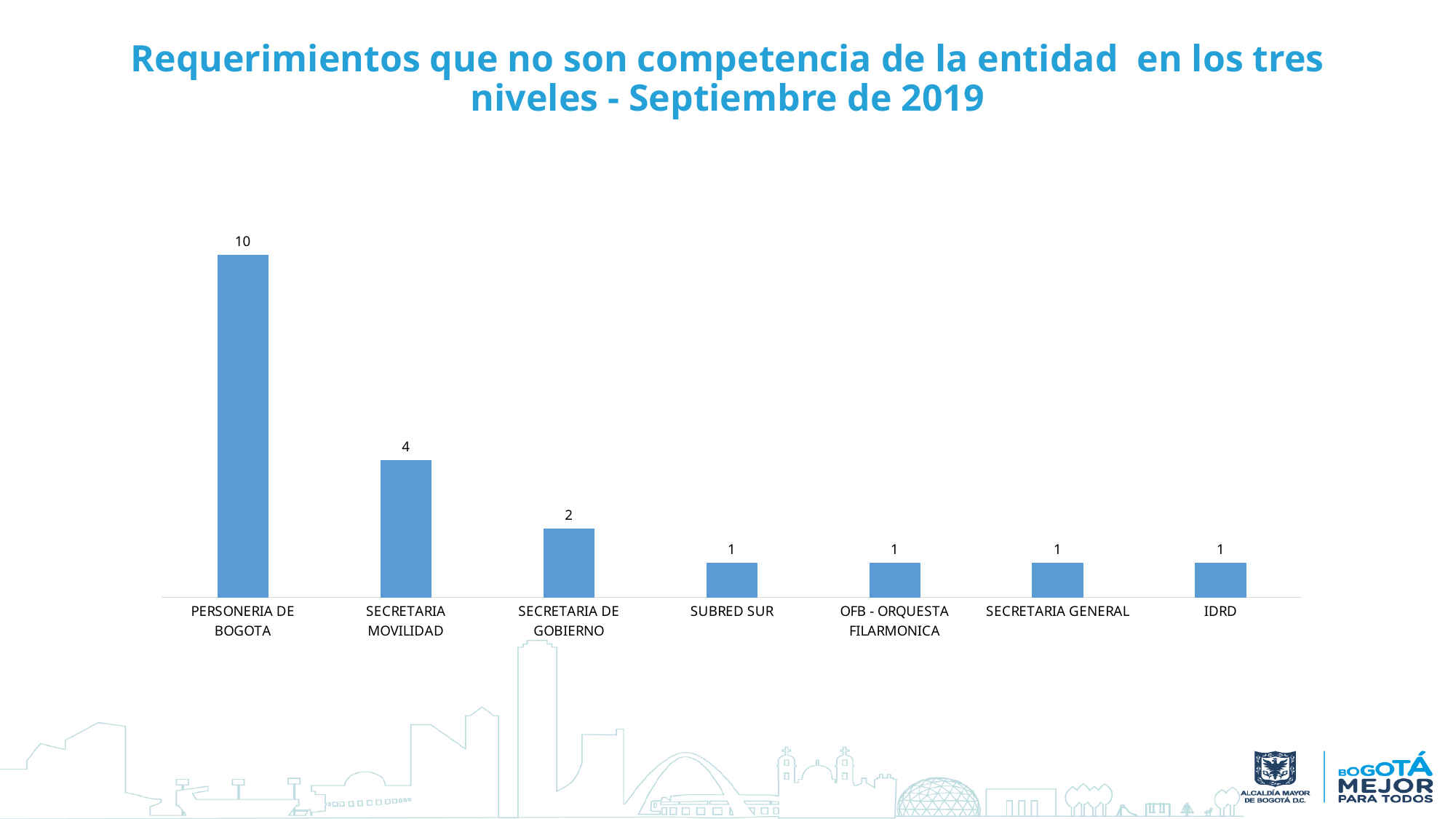
What is the value for SECRETARIA DE GOBIERNO? 2 Do the values rise or fall from left to right along the x axis? Fall What is the value for IDRD? 1 What kind of chart is shown on the slide? Bar chart What is the difference between the values for PERSONERIA DE BOGOTA and SECRETARIA MOVILIDAD? 6 What is the value for PERSONERIA DE BOGOTA? 10 How many categories are shown on the x axis? 7 What is the value for SECRETARIA MOVILIDAD? 4 What is the difference between the values for SECRETARIA MOVILIDAD and SECRETARIA DE GOBIERNO? 2 How many categories have a value of 1? 4 Which is larger, the value for SECRETARIA DE GOBIERNO or the value for SUBRED SUR? SECRETARIA DE GOBIERNO Which category has the highest value? PERSONERIA DE BOGOTA